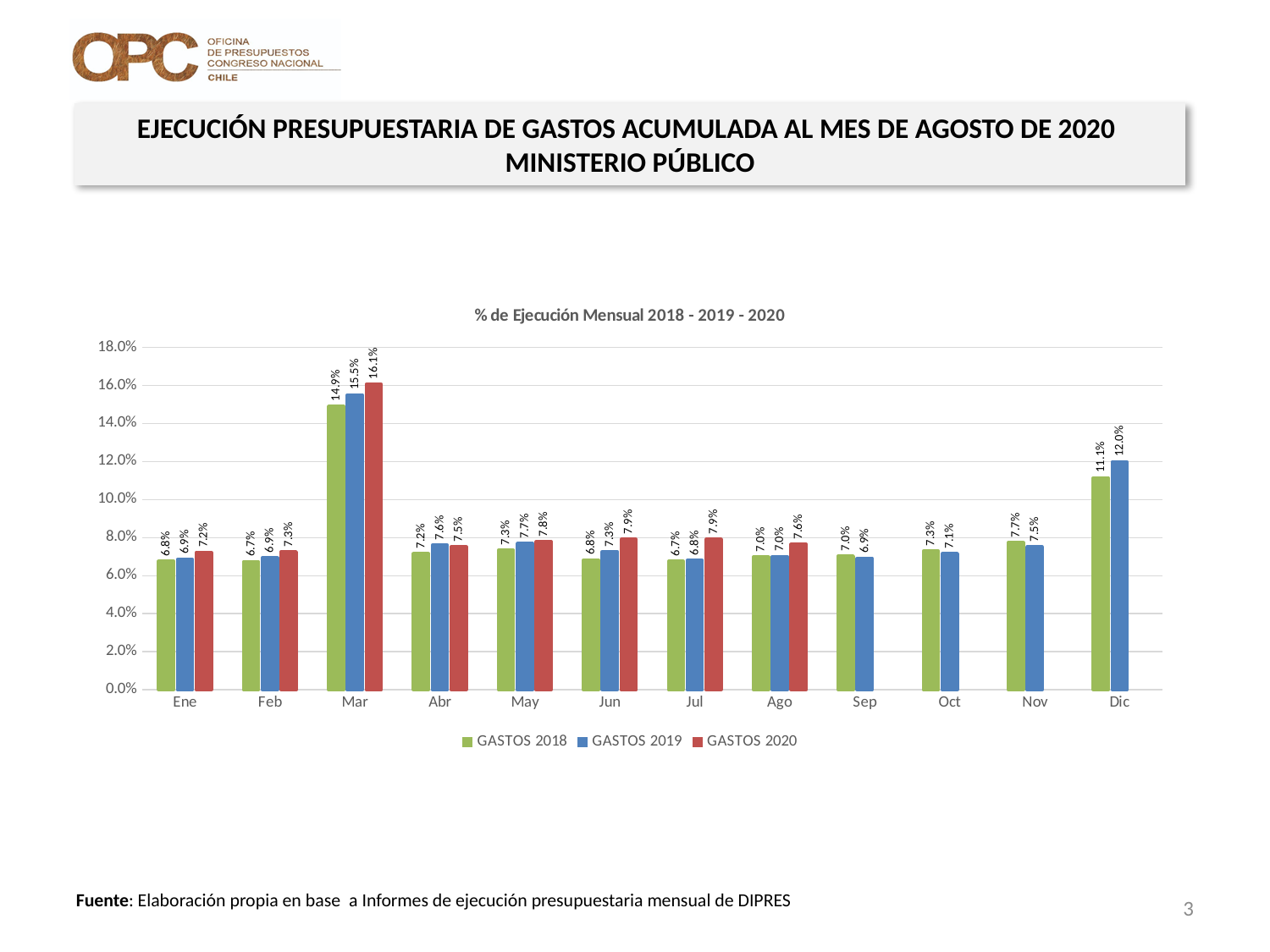
How many months are shown on the x axis? 12 What kind of chart is shown on the slide? Bar chart Which is larger in Jul: GASTOS 2020 or GASTOS 2018? GASTOS 2020 What is the value for GASTOS 2020 in Mar? 16.1% What is the title of the chart? % de Ejecución Mensual 2018 - 2019 - 2020 What is the difference between GASTOS 2020 and GASTOS 2018 in Mar? 1.2% Is the value for GASTOS 2019 in Dic greater or less than 10.0%? greater What is the value for GASTOS 2019 in Abr? 7.6% What is the value for GASTOS 2018 in Dic? 11.1% Which month has the highest value for GASTOS 2019? Mar How many series does the legend list? 3